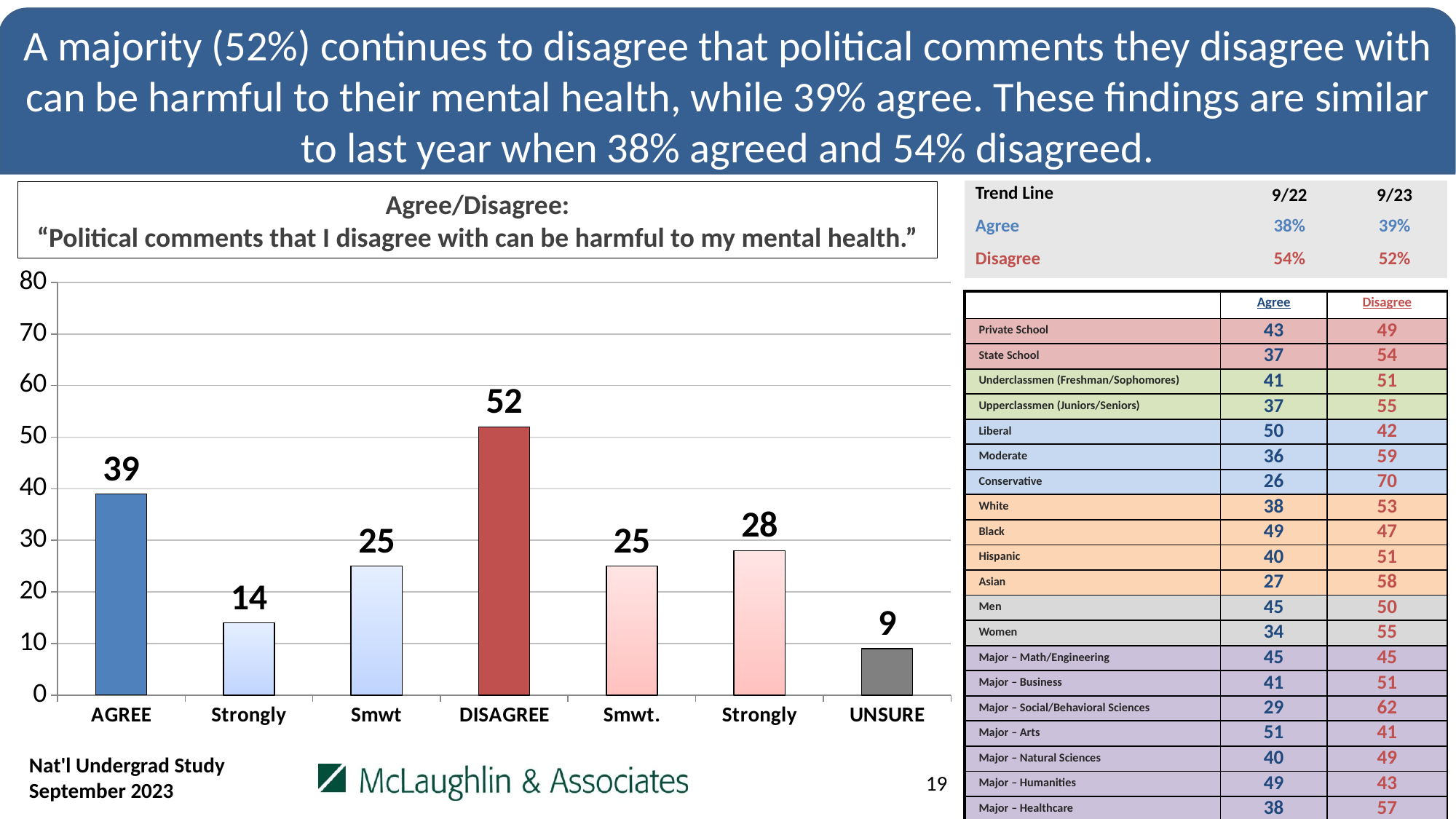
How many bars are shown in the chart? 7 What type of chart is shown on the slide? Bar chart What is the difference between the DISAGREE bar and the AGREE bar? 13 What is the highest value shown on the vertical axis of the chart? 80 What is the value of the Strongly bar immediately to the left of UNSURE? 28 What is the value of the DISAGREE bar? 52 Which category has the highest bar? DISAGREE What is the value of the AGREE bar? 39 What is the value of the Strongly bar immediately to the right of AGREE? 14 Which is larger, the Strongly bar next to AGREE or the Strongly bar next to UNSURE? Strongly next to UNSURE What is the value of the UNSURE bar? 9 Which category has the lowest bar? UNSURE